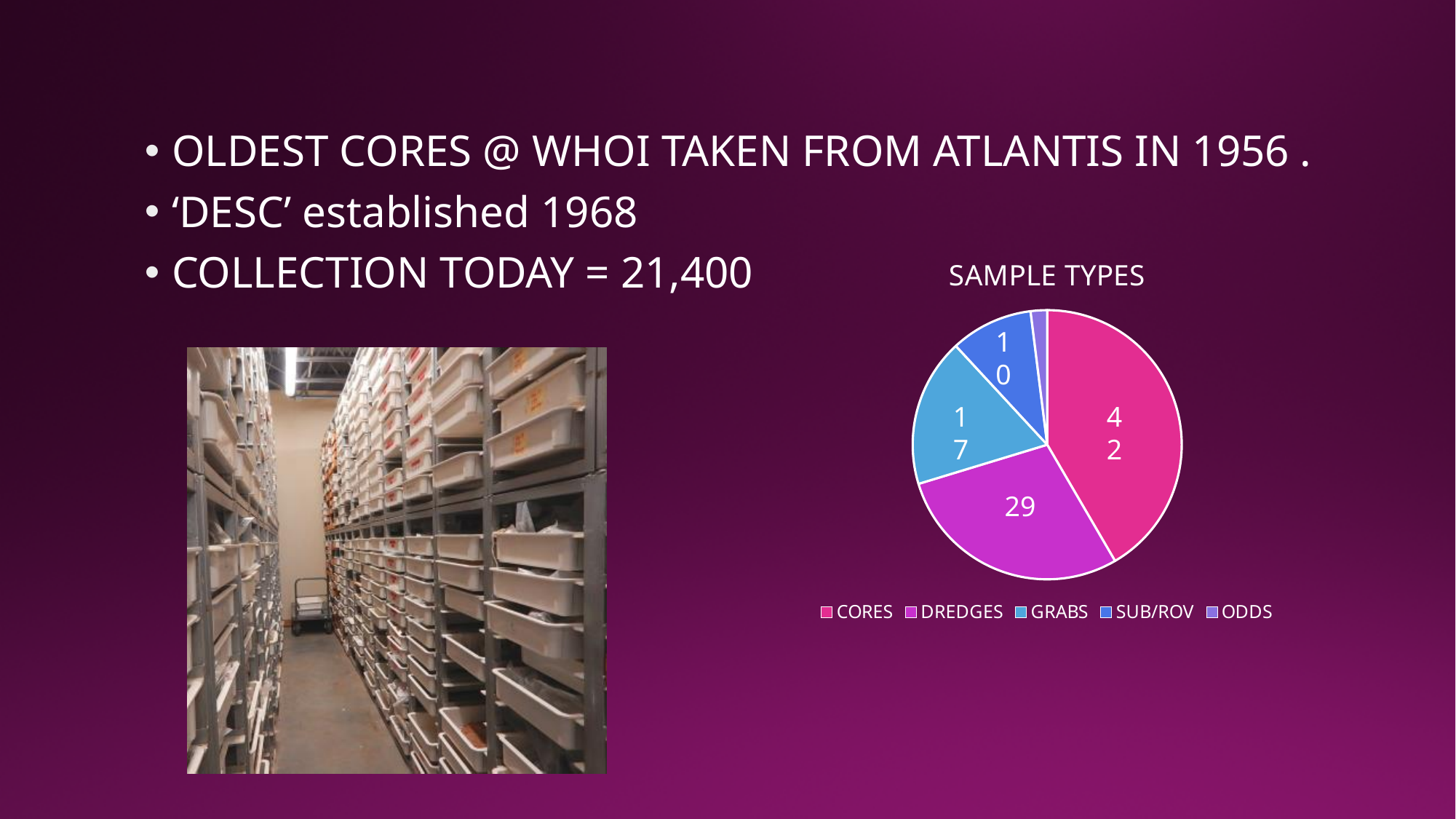
What is the value shown for CORES in the SAMPLE TYPES pie chart? 42 What is the value shown for GRABS in the SAMPLE TYPES pie chart? 17 What type of chart is shown on the slide? pie chart How many categories does the SAMPLE TYPES pie chart show? 5 Which is larger, the value for GRABS or the value for SUB/ROV? GRABS What is the title of the chart? SAMPLE TYPES What is the difference between the values for CORES and DREDGES? 13 What is the value shown for SUB/ROV in the SAMPLE TYPES pie chart? 10 Which sample type has the smallest slice in the pie chart? ODDS What is the value shown for DREDGES in the SAMPLE TYPES pie chart? 29 What is the difference between the values for DREDGES and GRABS? 12 Which sample type has the largest slice in the pie chart? CORES